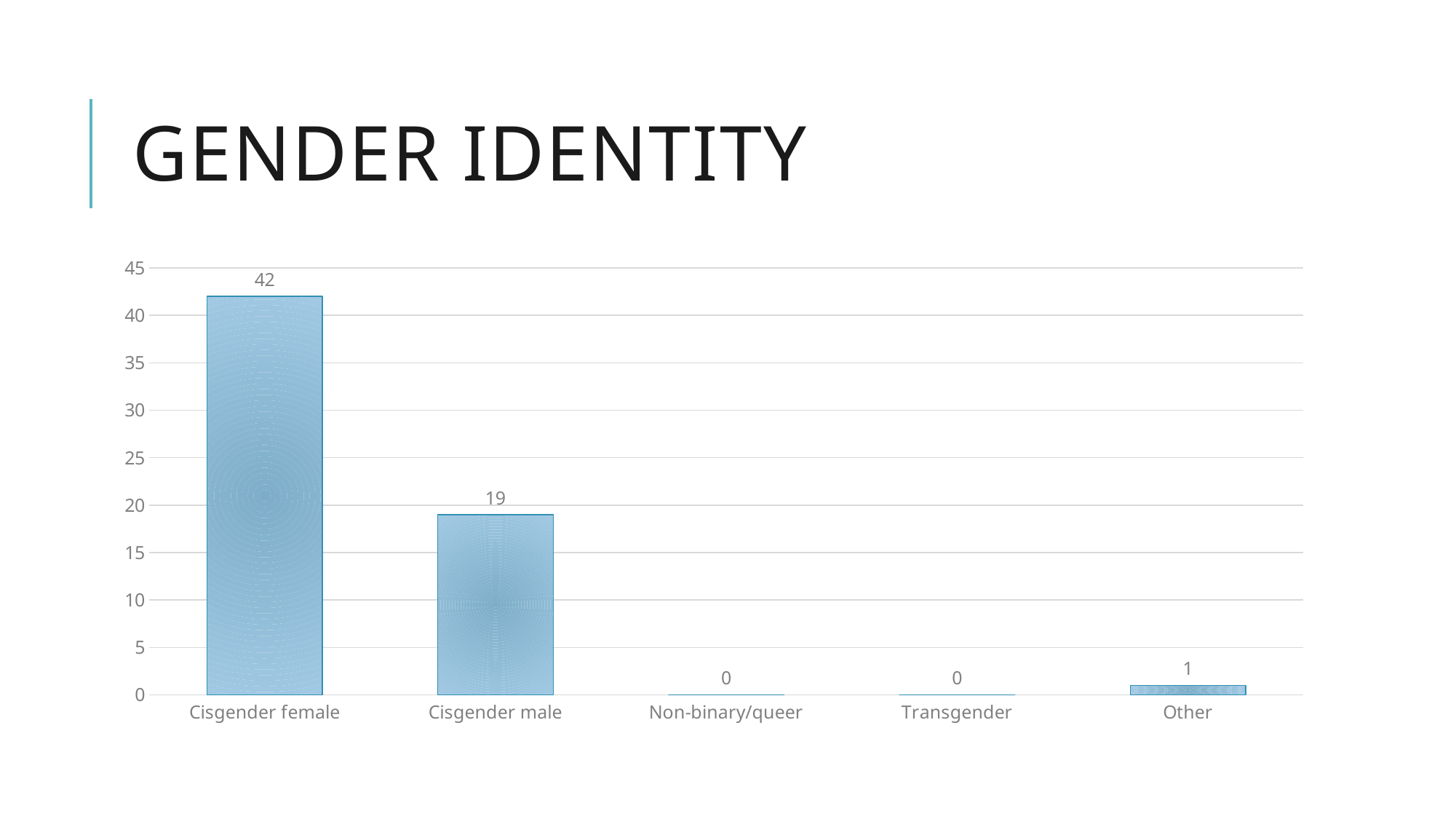
Which is larger, the value for Cisgender male or the value for Other? Cisgender male What is the value for Other? 1 What is the value for Transgender? 0 What is the title of the slide? GENDER IDENTITY How many categories are shown on the x axis? 5 What is the value for Cisgender male? 19 How many categories have a value of 0? 2 What kind of chart is shown on the slide? Bar chart What is the difference between the values for Cisgender female and Cisgender male? 23 Is the value for Cisgender female greater or less than 40? greater Which category has the highest value? Cisgender female What is the value for Cisgender female? 42